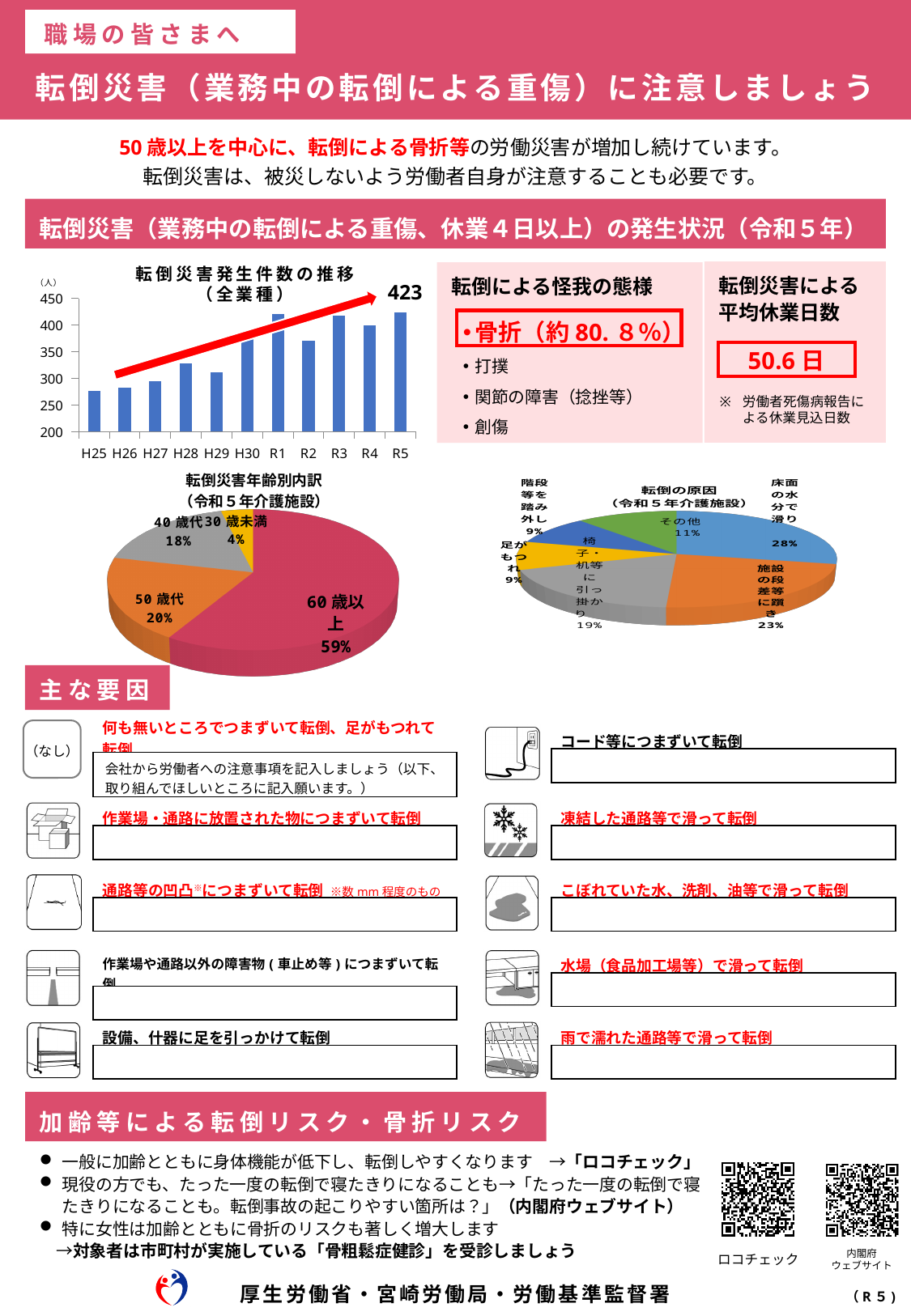
In the bar chart 転倒災害発生件数の推移（全業種）, what is the value for R5? 423 What kind of chart is 転倒災害発生件数の推移（全業種）? bar chart In the pie chart 転倒災害年齢別内訳（令和5年介護施設）, what share is 60歳以上? 59% In the pie chart 転倒災害年齢別内訳（令和5年介護施設）, which age group has the smallest share? 30歳未満 In the bar chart 転倒災害発生件数の推移（全業種）, which year has the highest value? R5 In the bar chart 転倒災害発生件数の推移（全業種）, is the value for H25 greater or less than 300? less In the pie chart 転倒の原因（令和5年介護施設）, what share is 床面の水分で滑り? 28% In the bar chart 転倒災害発生件数の推移（全業種）, do the values generally rise or fall from H25 to R5? rise In the pie chart 転倒の原因（令和5年介護施設）, which is larger: 施設の段差等に躓き or 椅子・机等に引っ掛かり? 施設の段差等に躓き In the bar chart 転倒災害発生件数の推移（全業種）, how many years (bars) are shown? 11 In the bar chart 転倒災害発生件数の推移（全業種）, is the value for R1 greater or less than 400? greater In the pie chart 転倒災害年齢別内訳（令和5年介護施設）, what is the difference in percentage points between 50歳代 and 40歳代? 2